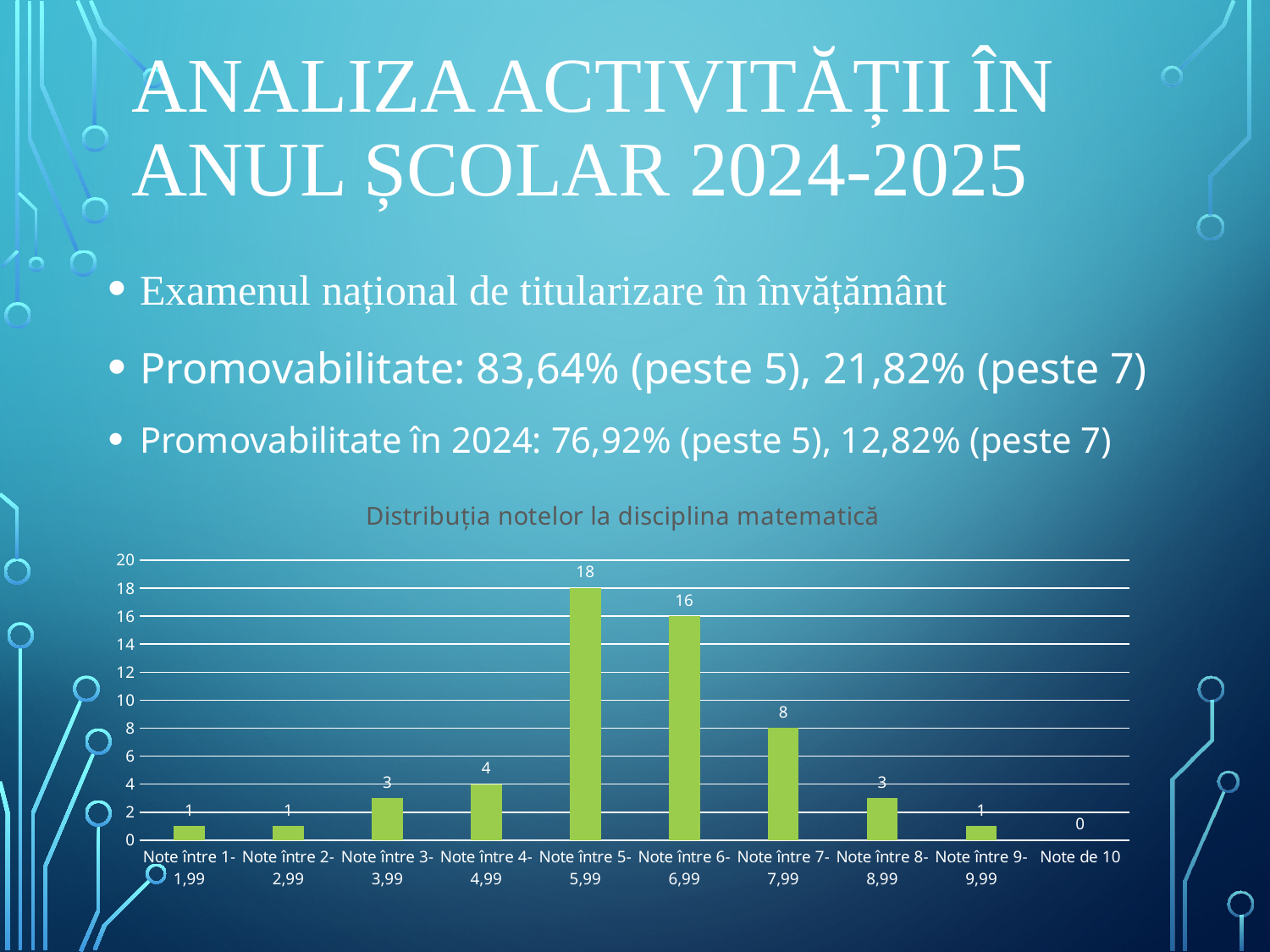
Which category has the lowest value? Note de 10 What type of chart is shown on the slide? bar chart Which category has the highest value? Note între 5-5,99 What is the value for 'Note între 5-5,99'? 18 What is the difference between the values for 'Note între 5-5,99' and 'Note între 6-6,99'? 2 Which is larger, the value for 'Note între 4-4,99' or the value for 'Note între 3-3,99'? Note între 4-4,99 What is the title of the chart? Distribuția notelor la disciplina matematică What is the value for 'Note de 10'? 0 How many categories are shown on the x axis of the chart? 10 Is the value for 'Note între 6-6,99' greater or less than 10? greater What is the value for 'Note între 7-7,99'? 8 What is the difference between the values for 'Note între 7-7,99' and 'Note între 8-8,99'? 5